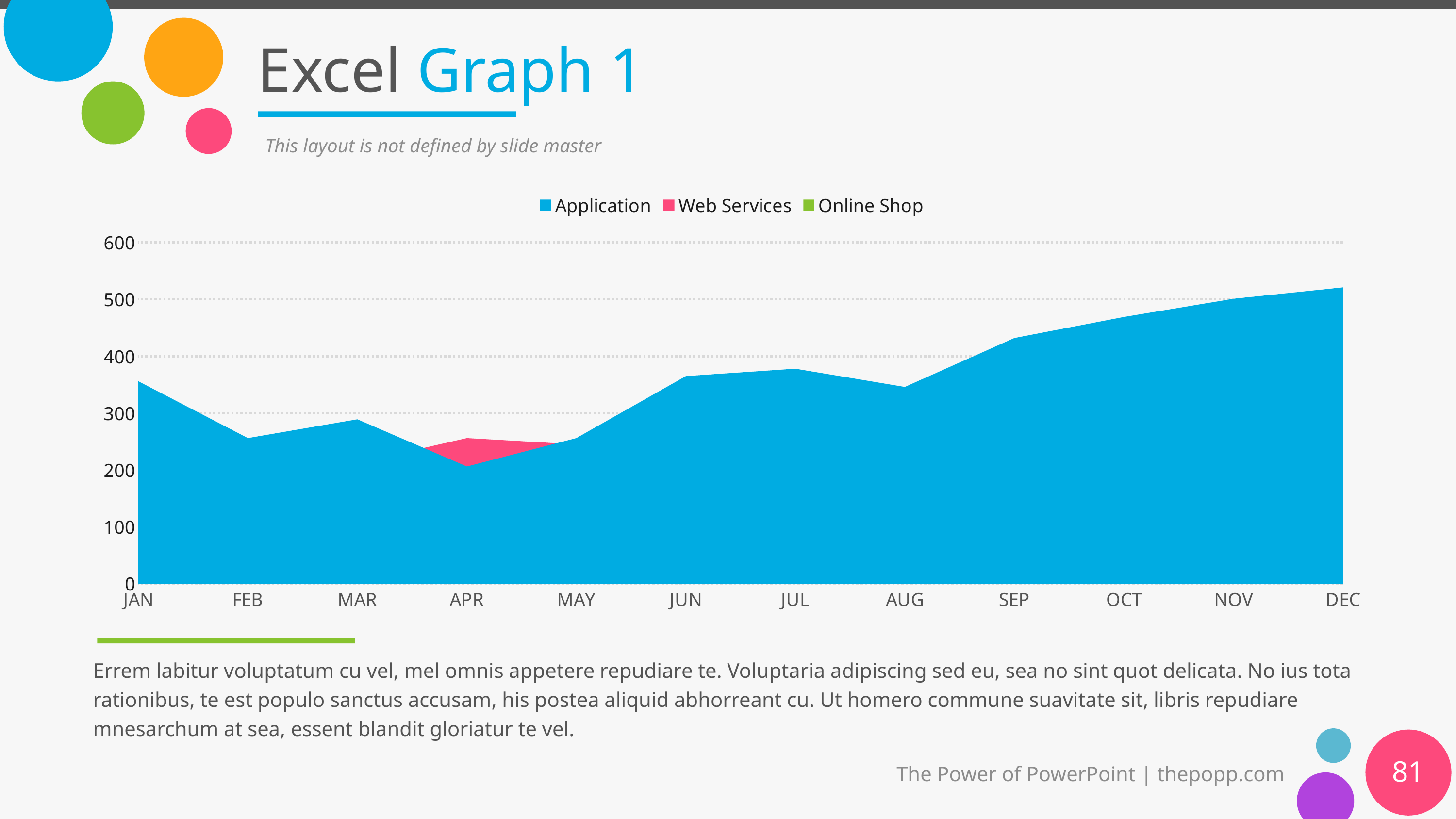
How many months are shown along the x axis? 12 In which month does the Application series reach its highest value? DEC What kind of chart is shown on the slide? Area chart Is the Application value for JAN greater or less than 300? greater How many series does the legend list? 3 Is the Application value for SEP greater or less than 400? greater Which month has the larger Application value, JAN or FEB? JAN Is the Application value for APR greater or less than 300? less Does the Application series rise or fall from AUG to DEC? rise In which month does the Application series reach its lowest value? APR Which series are listed in the legend? Application, Web Services, Online Shop